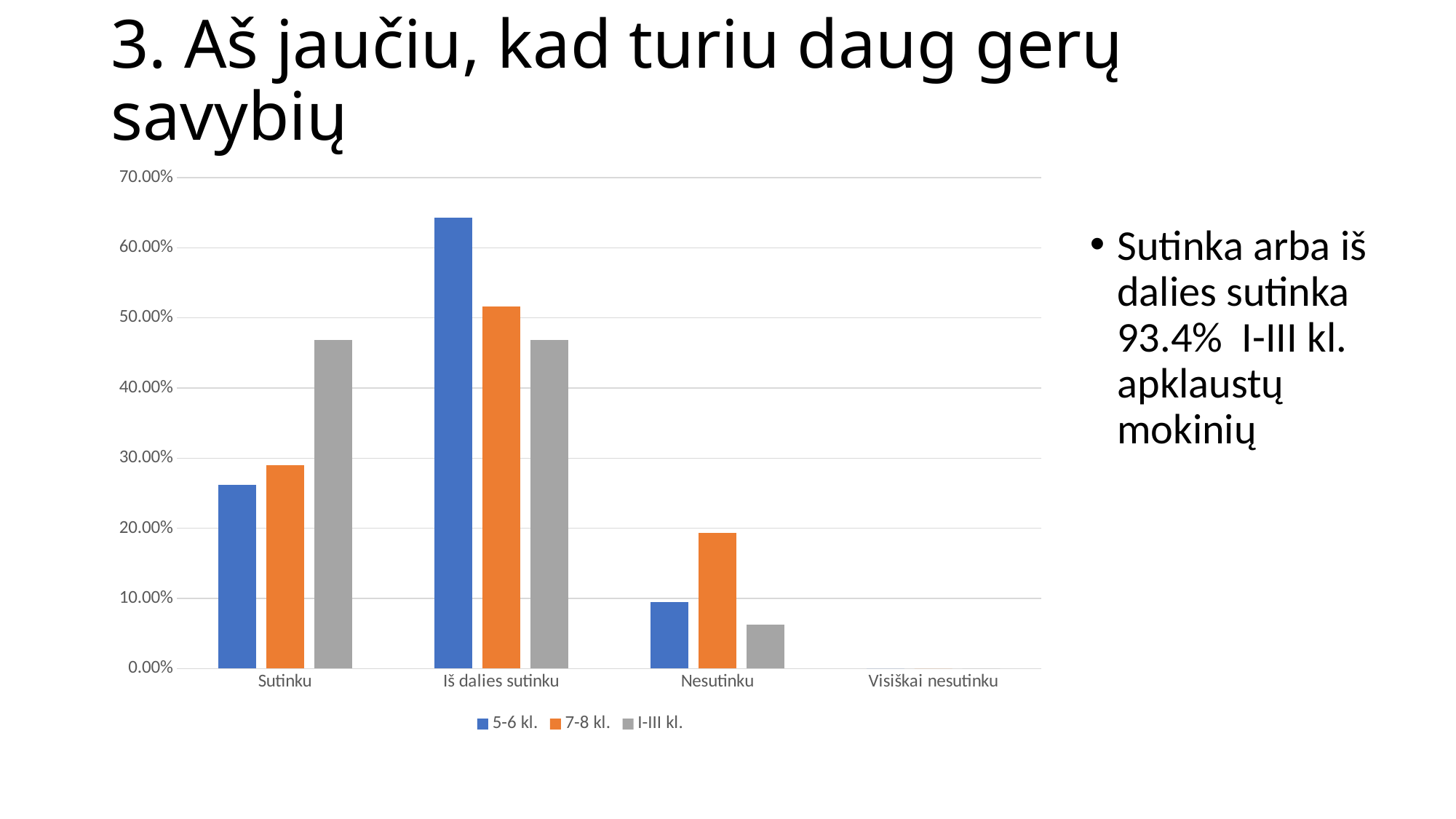
Is the value for 5-6 kl. in the Iš dalies sutinku category greater or less than 60.00%? greater What colour represents the 7-8 kl. series in the chart? orange Which category has the highest bar for the 5-6 kl. series? Iš dalies sutinku What kind of chart is shown on the slide? bar chart Which series has the highest bar in the Iš dalies sutinku category? 5-6 kl. How many categories are shown on the x axis of the chart? 4 How many series does the chart legend list? 3 Which series has the lowest bar in the Nesutinku category? I-III kl. Is the value for 7-8 kl. in the Nesutinku category greater or less than 10.00%? greater Is the value for 5-6 kl. in the Sutinku category greater or less than 30.00%? less In the Nesutinku category, which is larger: the 7-8 kl. bar or the 5-6 kl. bar? 7-8 kl.